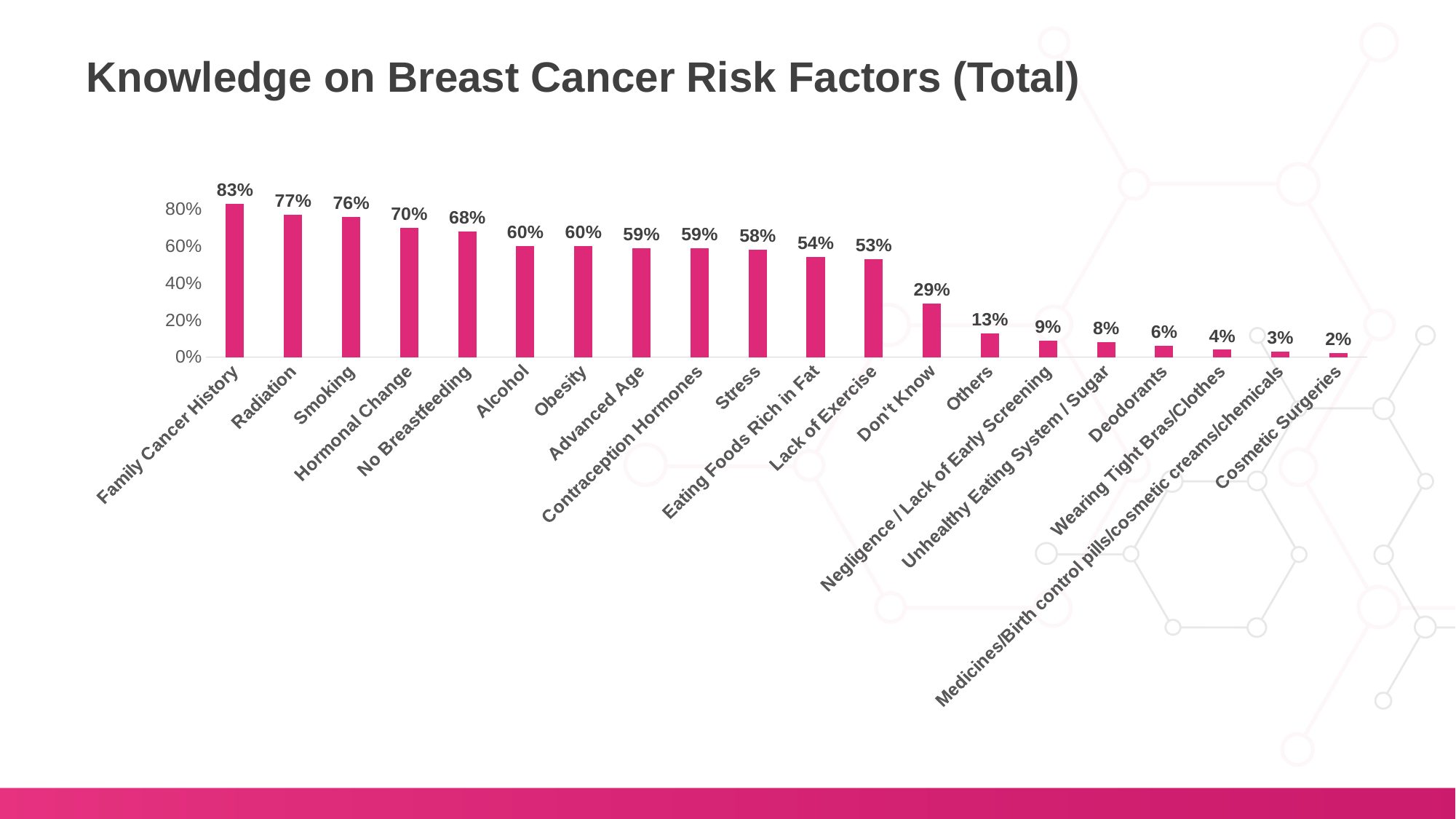
What is the value for Family Cancer History? 83% What is the difference between the values for Radiation and Lack of Exercise? 24% What kind of chart is shown on the slide? Bar chart What is the value for Deodorants? 6% What is the value for Stress? 58% Is the value for No Breastfeeding greater or less than 60%? greater Which risk factor has the highest value? Family Cancer History What is the value for Don't Know? 29% Which risk factor has the lowest value? Cosmetic Surgeries How many risk factor categories are shown on the chart? 20 Which is larger, the value for Smoking or the value for Hormonal Change? Smoking What is the title of the chart? Knowledge on Breast Cancer Risk Factors (Total)